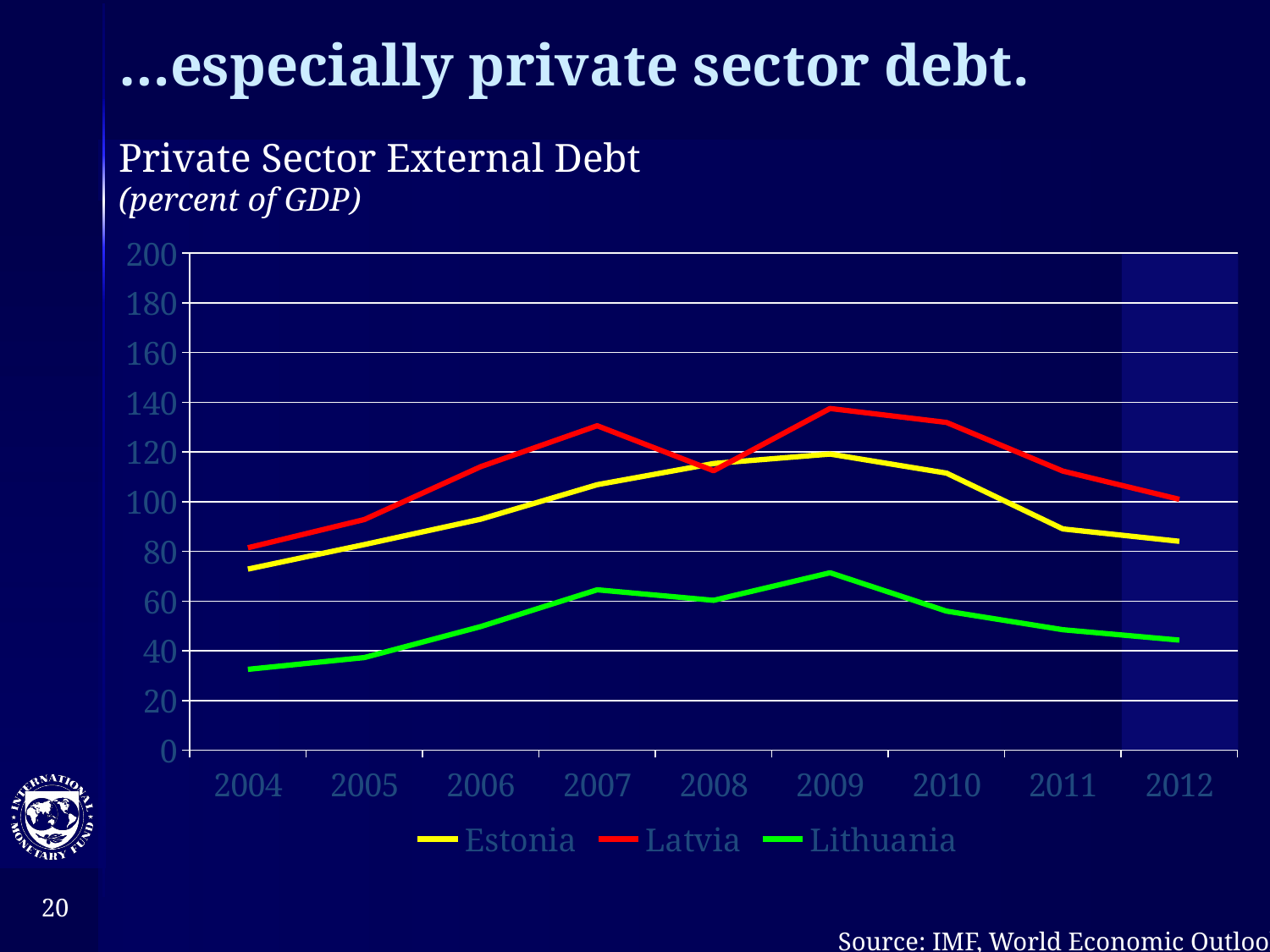
Which series has the lowest values across all years shown? Lithuania In which year does Latvia reach its highest value? 2009 In which year does Lithuania reach its lowest value? 2004 Is the value for Lithuania in 2004 greater or less than 40? less Is the value for Estonia in 2012 greater or less than 100? less Which series is drawn in green? Lithuania Does the value for Estonia rise or fall from 2009 to 2012? fall In 2012, which is larger: the value for Latvia or the value for Estonia? Latvia How many years are shown on the x axis? 9 How many series does the legend list? 3 What kind of chart is shown on the slide? line chart Is the value for Latvia in 2009 greater or less than 120? greater